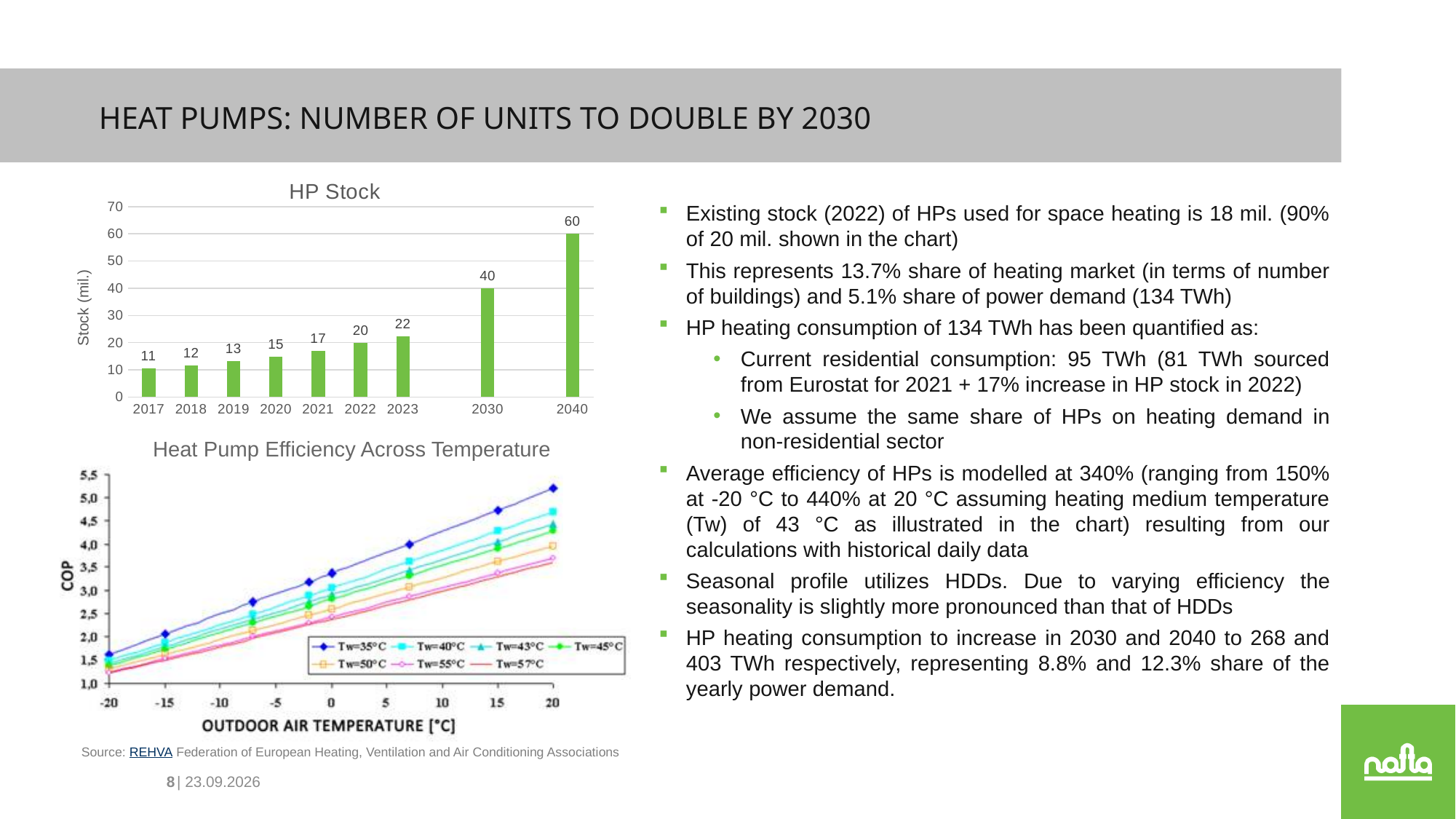
In the HP Stock chart, what is the stock value for 2022? 20 In the HP Stock chart, what is the stock value for 2040? 60 In the HP Stock chart, which year has the highest stock? 2040 What kind of chart is the HP Stock chart? bar chart In the HP Stock chart, which is larger, the value for 2019 or the value for 2021? 2021 In the HP Stock chart, what is the difference between the stock in 2030 and the stock in 2023? 18 In the Heat Pump Efficiency Across Temperature chart, how many series does the legend list? 7 In the Heat Pump Efficiency Across Temperature chart, is the COP for Tw=35°C at 20 °C outdoor air temperature greater or less than 5.0? greater In the HP Stock chart, do the values rise or fall from 2017 to 2040? rise In the HP Stock chart, how many years are shown on the x axis? 9 In the HP Stock chart, which year has the lowest stock? 2017 In the Heat Pump Efficiency Across Temperature chart, what is the label of the y axis? COP